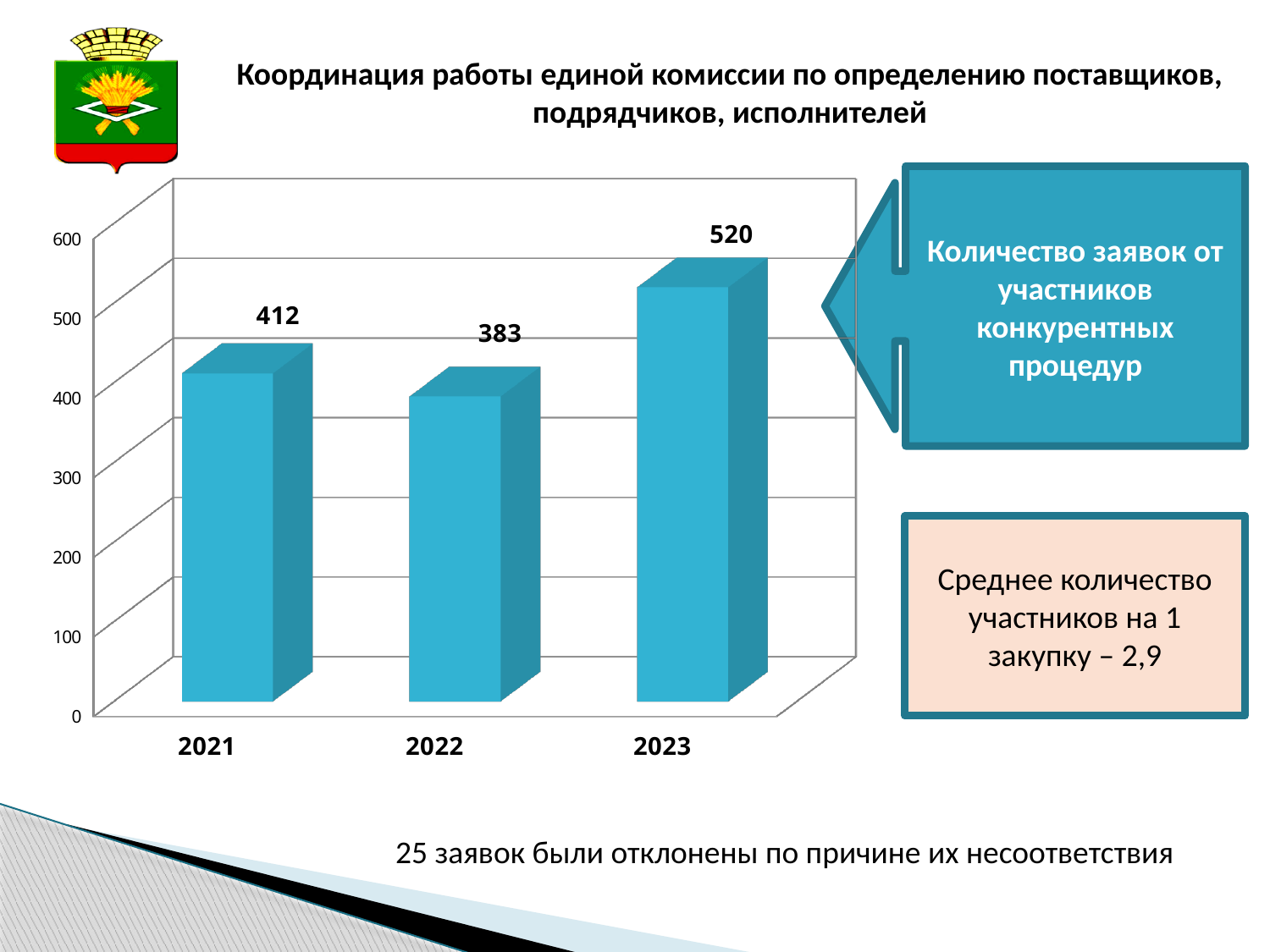
Is the value for 2023 greater or less than 500? greater What is the value for 2022? 383 Which year has the lowest value? 2022 What is the value for 2023? 520 What is the highest value shown on the vertical axis? 600 What is the value for 2021? 412 What is the difference between the values for 2021 and 2022? 29 What is the difference between the values for 2023 and 2021? 108 Which is larger, the value for 2021 or the value for 2022? 2021 What kind of chart is shown on the slide? bar chart How many years are shown on the x axis? 3 Which year has the highest value? 2023